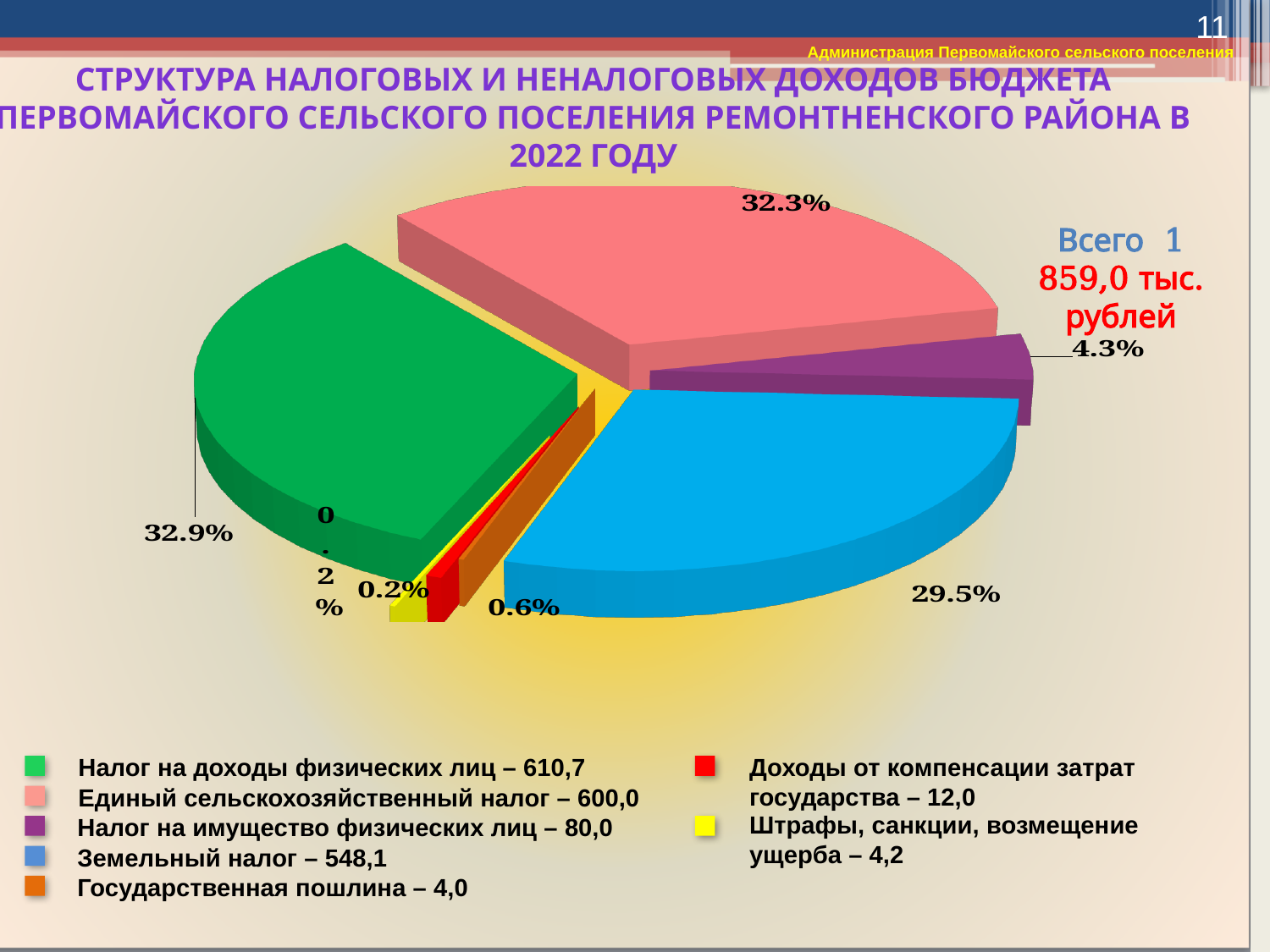
What share of the pie does Земельный налог (blue slice) represent? 29.5% What share of the pie does Налог на имущество физических лиц (purple slice) represent? 4.3% Which category has the largest share of the pie? Налог на доходы физических лиц Which is larger: the share for Налог на доходы физических лиц or the share for Единый сельскохозяйственный налог? Налог на доходы физических лиц What is the difference in percentage points between the share for Земельный налог and the share for Налог на имущество физических лиц? 25.2 How many categories does the legend list? 7 What share of the pie does Доходы от компенсации затрат государства (red slice) represent? 0.6% What total amount is stated next to the pie chart? 1 859,0 тыс. рублей What type of chart is shown on the slide? pie chart What value is given in the legend for Земельный налог? 548,1